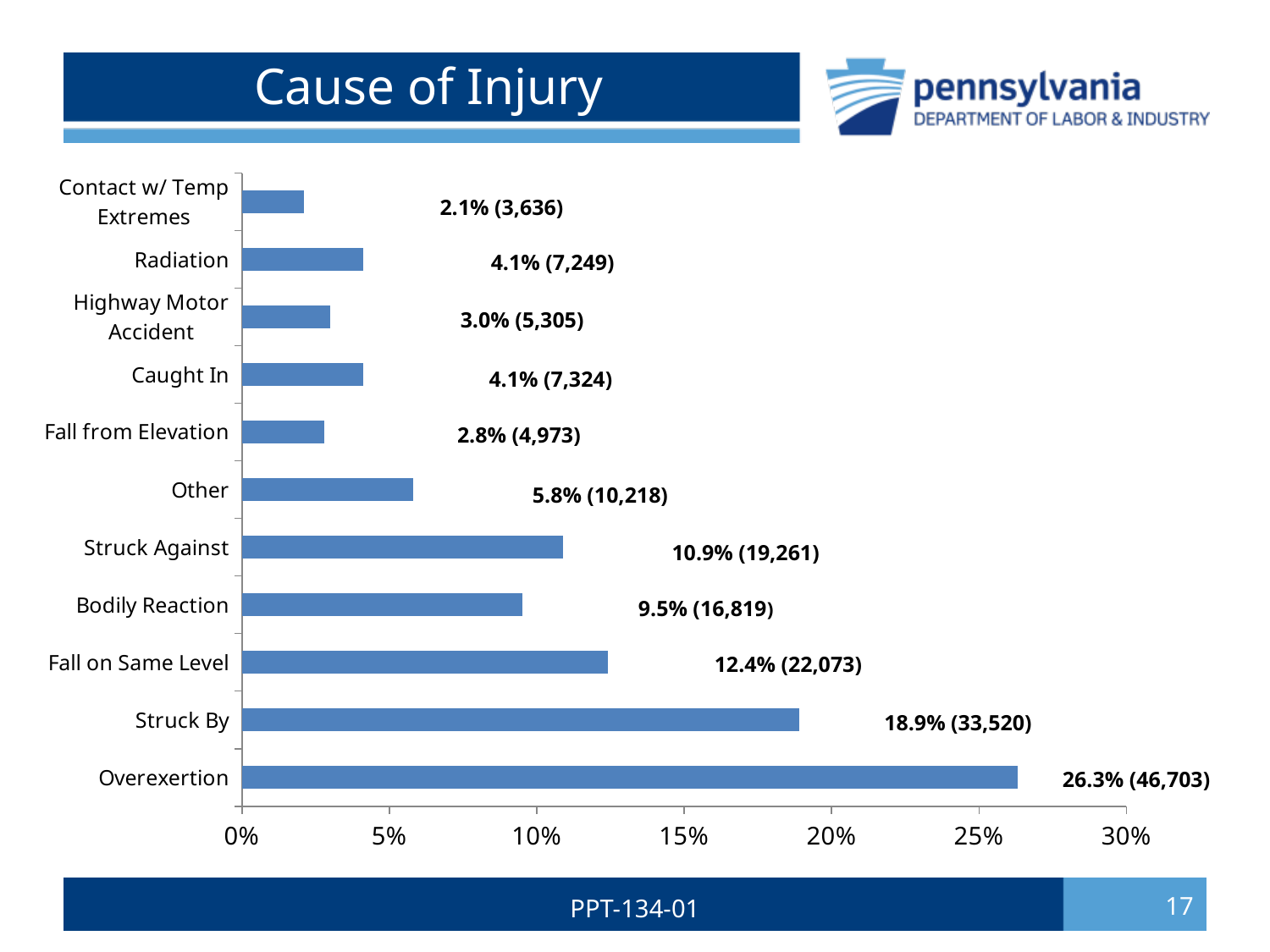
What is the difference in percentage points between Overexertion and Struck By? 7.4 What is the title of the slide? Cause of Injury What is the value for Contact w/ Temp Extremes? 2.1% (3,636) What is the value for Fall on Same Level? 12.4% (22,073) Which cause of injury has the lowest value? Contact w/ Temp Extremes What is the value for Struck By? 18.9% (33,520) What kind of chart is shown on the slide? Bar chart What is the value for Overexertion? 26.3% (46,703) Is the value for Struck By greater or less than 20%? less Which is larger, Struck Against or Bodily Reaction? Struck Against Which cause of injury has the highest value? Overexertion How many categories are shown in the chart? 11